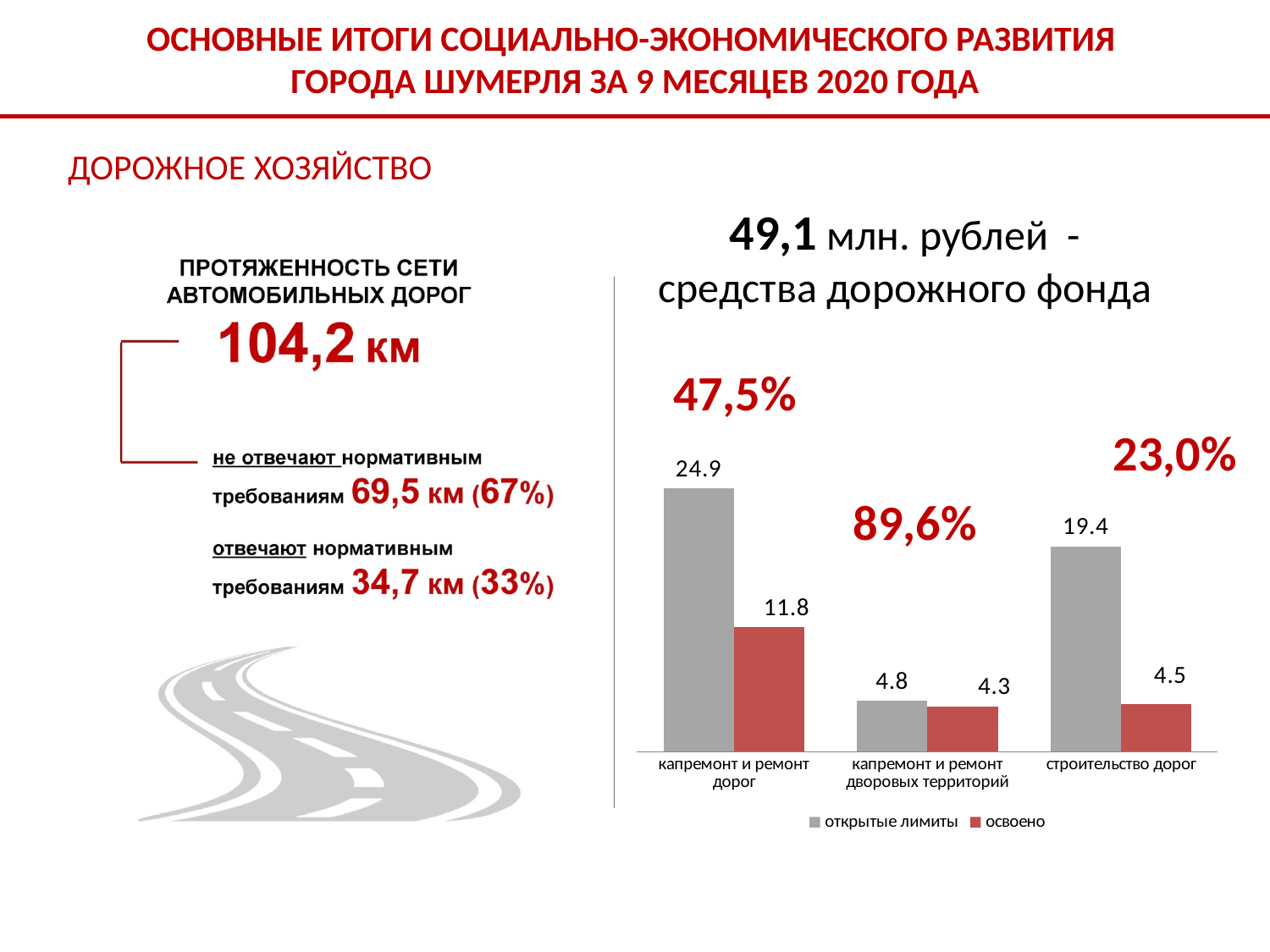
What is the value of 'освоено' for 'капремонт и ремонт дорог'? 11.8 What is the value of 'открытые лимиты' for 'строительство дорог'? 19.4 How many series does the chart legend list? 2 What is the value of 'открытые лимиты' for 'капремонт и ремонт дорог'? 24.9 What is the value of 'освоено' for 'капремонт и ремонт дворовых территорий'? 4.3 Which category has the lowest value for 'освоено'? капремонт и ремонт дворовых территорий How many categories are shown on the x axis of the chart? 3 Which is larger for 'капремонт и ремонт дворовых территорий': 'открытые лимиты' or 'освоено'? открытые лимиты What is the difference between 'открытые лимиты' and 'освоено' for 'строительство дорог'? 14.9 What type of chart is shown on the slide? bar chart Which category has the highest value for 'открытые лимиты'? капремонт и ремонт дорог Which series is shown in red in the chart? освоено